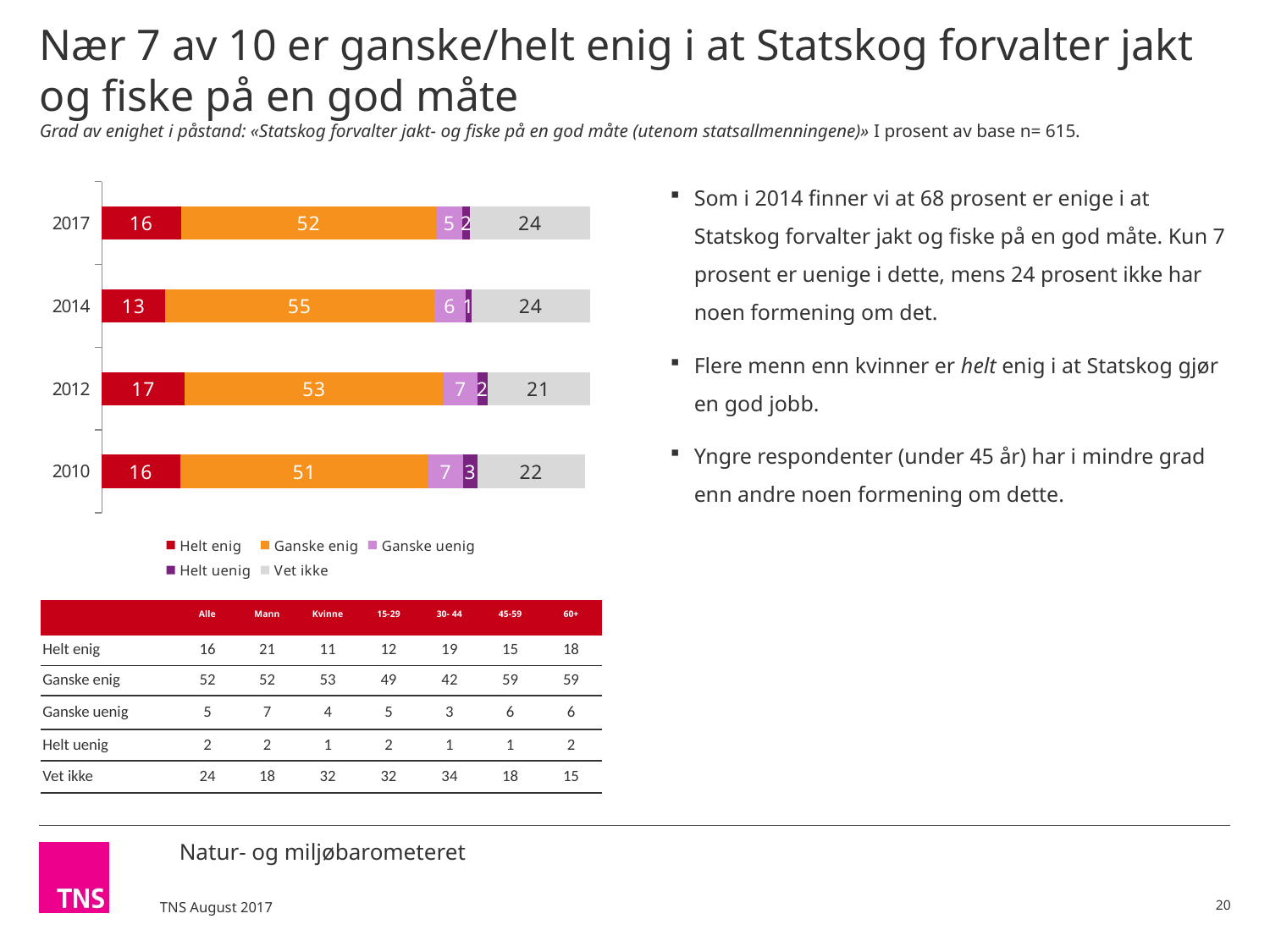
Which is larger: the Vet ikke value for 2017 or for 2012? 2017 What is the difference between the Ganske enig values for 2014 and 2010? 4 What is the total of the stacked bar for 2017? 99 Which series is shown in orange in the chart? Ganske enig How many series does the chart legend list? 5 Which year has the highest value for Ganske enig? 2014 Which year has the lowest value for Helt enig? 2014 What is the value for Helt enig in 2012? 17 What is the value for Ganske enig in 2014? 55 What kind of chart is shown on the slide? Stacked bar chart How many years (categories) are plotted in the chart? 4 What is the value for Vet ikke in 2010? 22